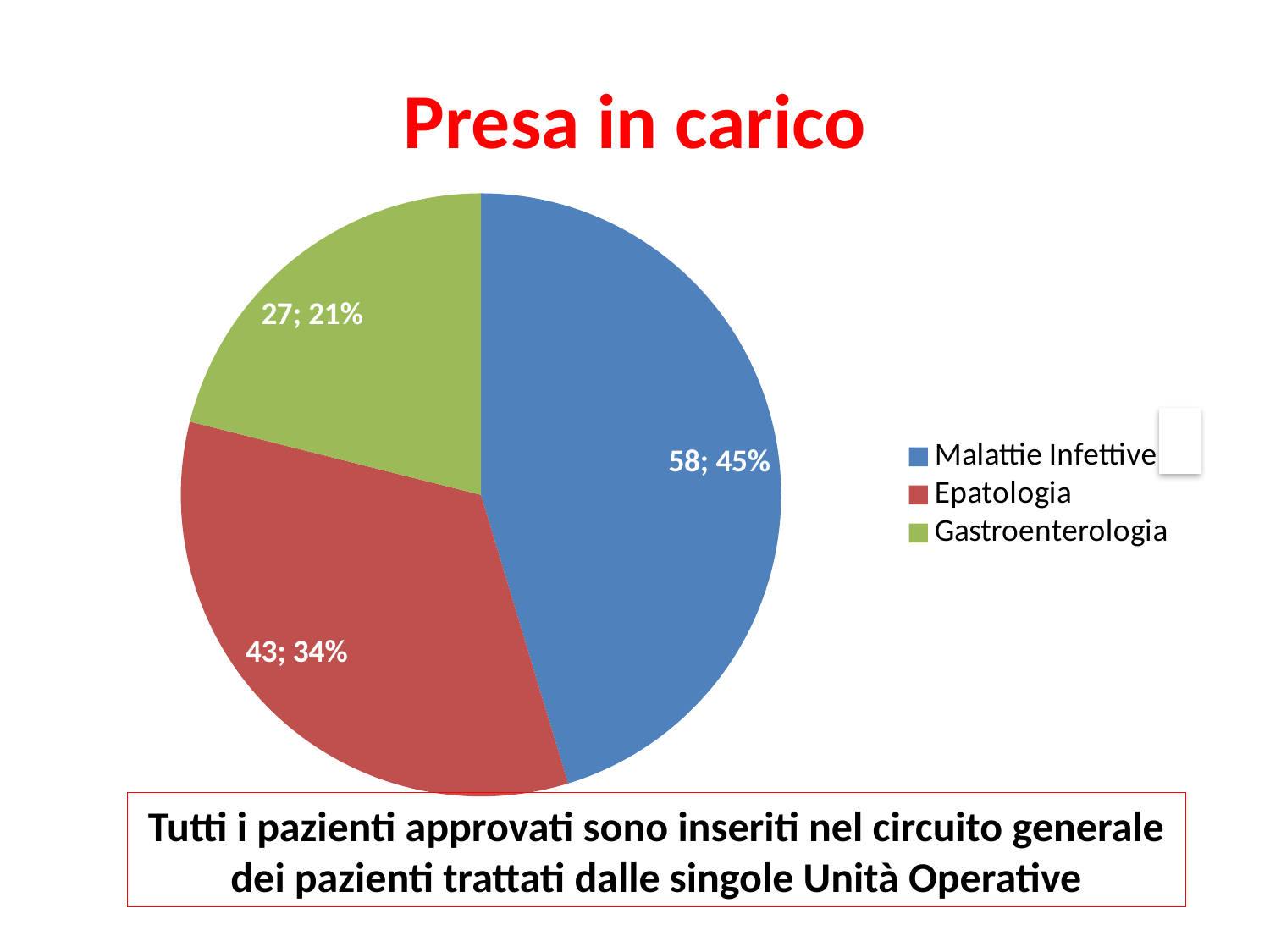
How many slices does the pie chart have? 3 What is the value for Malattie Infettive? 58 Which category has the largest slice? Malattie Infettive Which category has the smallest slice? Gastroenterologia What kind of chart is shown on the slide? pie chart What is the difference between the values for Malattie Infettive and Epatologia? 15 What share of the pie does Malattie Infettive represent? 45% What is the value for Epatologia? 43 How many entries does the legend list? 3 What share of the pie does Gastroenterologia represent? 21% What is the title of the chart? Presa in carico What is the value for Gastroenterologia? 27